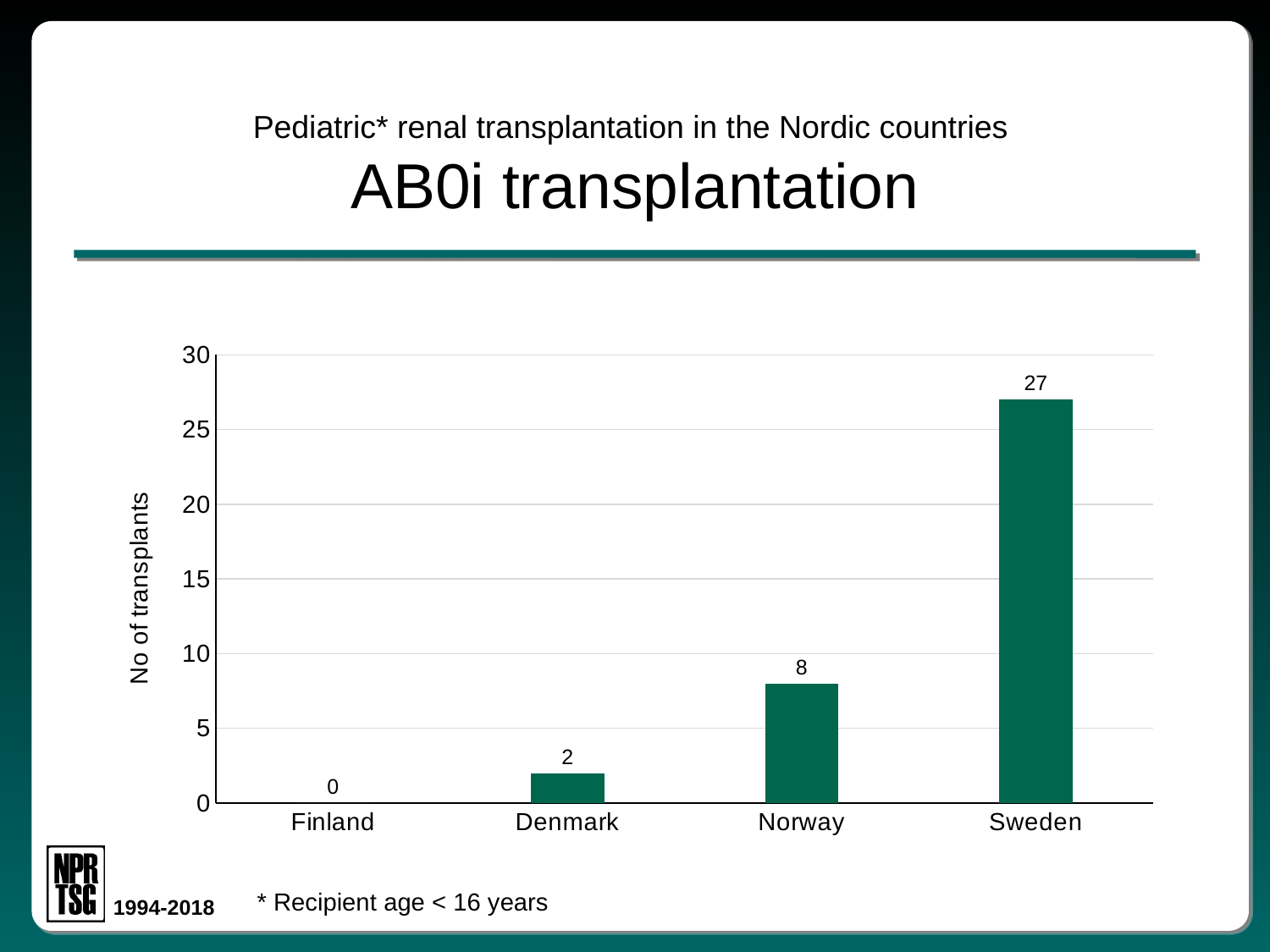
Is the value for Sweden greater or less than 25? greater What is the label of the y axis? No of transplants Which has more transplants, Denmark or Norway? Norway What is the difference between the values for Sweden and Norway? 19 Which country has the lowest number of AB0i transplants? Finland Which country has the highest number of AB0i transplants? Sweden What value is shown for Denmark? 2 What kind of chart is shown on the slide? Bar chart How many countries are shown on the x axis? 4 How many AB0i transplants are shown for Sweden? 27 What is the number of transplants for Norway? 8 What value is shown for Finland? 0